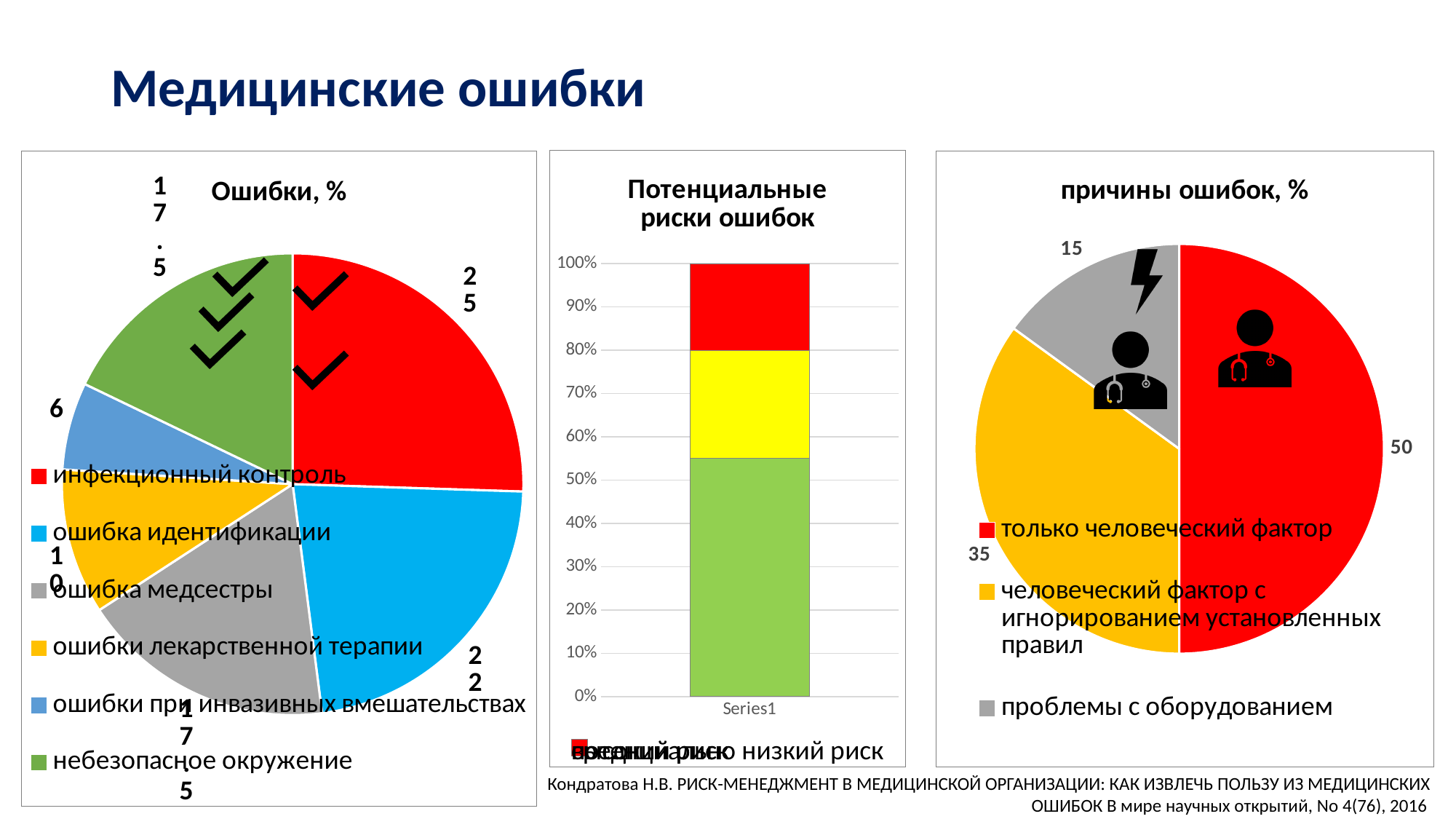
In the chart titled "причины ошибок, %", what is the value for "человеческий фактор с игнорированием установленных правил"? 35 In the chart titled "причины ошибок, %", what is the difference between the values for "только человеческий фактор" and "проблемы с оборудованием"? 35 In the chart titled "причины ошибок, %", how many categories does the legend list? 3 What kind of chart is the middle chart titled "Потенциальные риски ошибок"? stacked bar chart In the chart titled "Ошибки, %", which category has the smallest share? ошибки при инвазивных вмешательствах In the chart titled "причины ошибок, %", what is the value for "проблемы с оборудованием"? 15 In the chart titled "причины ошибок, %", which category has the largest share? только человеческий фактор In the chart titled "причины ошибок, %", what is the value for "только человеческий фактор"? 50 In the chart titled "Ошибки, %", what is the value for "ошибки при инвазивных вмешательствах"? 6 In the chart titled "Ошибки, %", what is the value for "инфекционный контроль"? 25 In the chart titled "Потенциальные риски ошибок", is the green segment of the bar greater or less than 50%? greater In the chart titled "Ошибки, %", how many categories does the legend list? 6